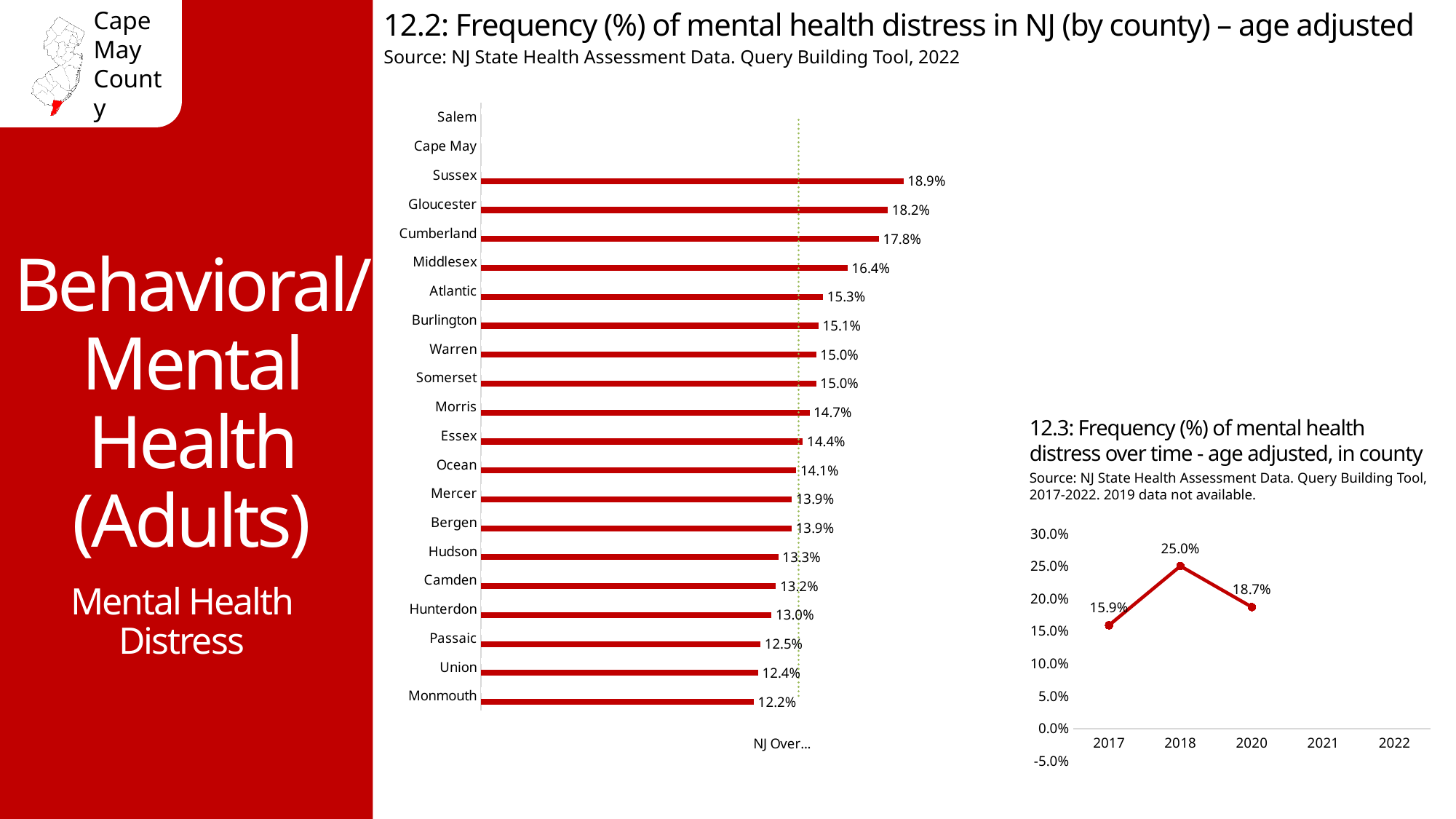
In chart 12.2, what kind of chart is shown? bar chart In chart 12.2, which county has the highest plotted value? Sussex In chart 12.3, what is the value for 2018? 25.0% In chart 12.2, what is the value for Sussex? 18.9% In chart 12.3, what is the difference between the values for 2018 and 2020? 6.3% In chart 12.2, what is the value for Monmouth? 12.2% In chart 12.3, how many data points are plotted on the line? 3 In chart 12.2, which county has the lowest plotted value? Monmouth In chart 12.2, how many county labels are listed on the vertical axis? 21 In chart 12.3, is the value for 2017 greater or less than 20.0%? less In chart 12.2, what is the difference between the values for Gloucester and Cumberland? 0.4% In chart 12.2, which is larger, the value for Middlesex or the value for Atlantic? Middlesex